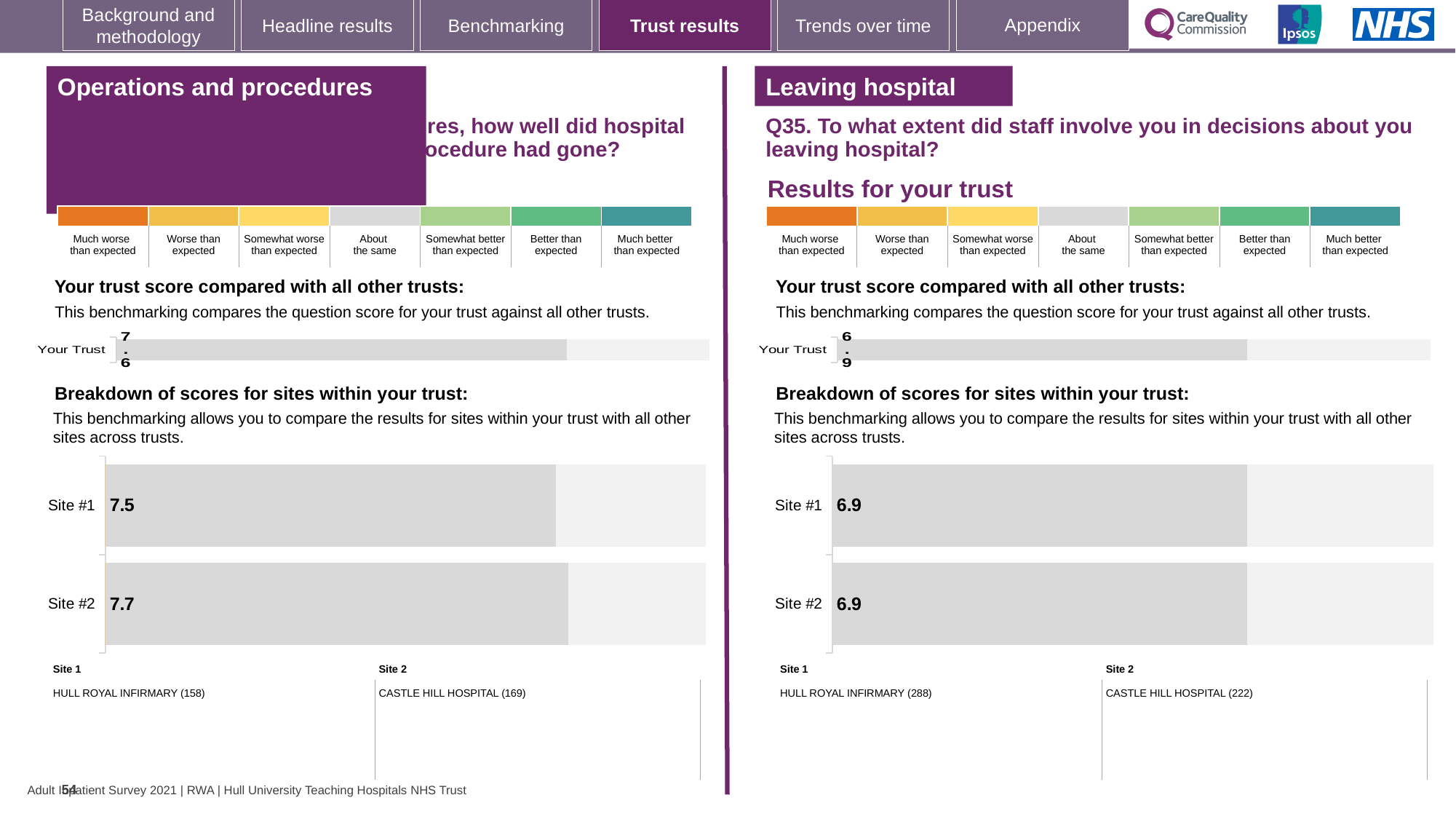
On the right-hand 'Leaving hospital' (Q35) site breakdown chart, what is the score for Site #1? 6.9 On the right-hand 'Leaving hospital' section, which hospital is listed as Site 2? CASTLE HILL HOSPITAL (222) On the left-hand 'Operations and procedures' site breakdown chart, what is the difference between the Site #2 and Site #1 scores? 0.2 Is the Site #1 score on the left-hand 'Operations and procedures' site breakdown chart larger or smaller than the Site #1 score on the right-hand 'Leaving hospital' site breakdown chart? Larger What kind of chart is used for the site breakdown on the left-hand 'Operations and procedures' section? Bar chart On the left-hand 'Operations and procedures' site breakdown chart, what is the score for Site #1? 7.5 On the left-hand 'Operations and procedures' site breakdown chart, what is the score for Site #2? 7.7 On the left-hand 'Operations and procedures' site breakdown chart, which site has the higher score? Site #2 On the right-hand 'Leaving hospital' (Q35) site breakdown chart, how many sites are shown? 2 On the right-hand 'Leaving hospital' (Q35) 'Your trust score compared with all other trusts' chart, what is the score for Your Trust? 6.9 On the left-hand 'Operations and procedures' 'Your trust score compared with all other trusts' chart, what is the score for Your Trust? 7.6 On the right-hand 'Leaving hospital' (Q35) site breakdown chart, what is the score for Site #2? 6.9